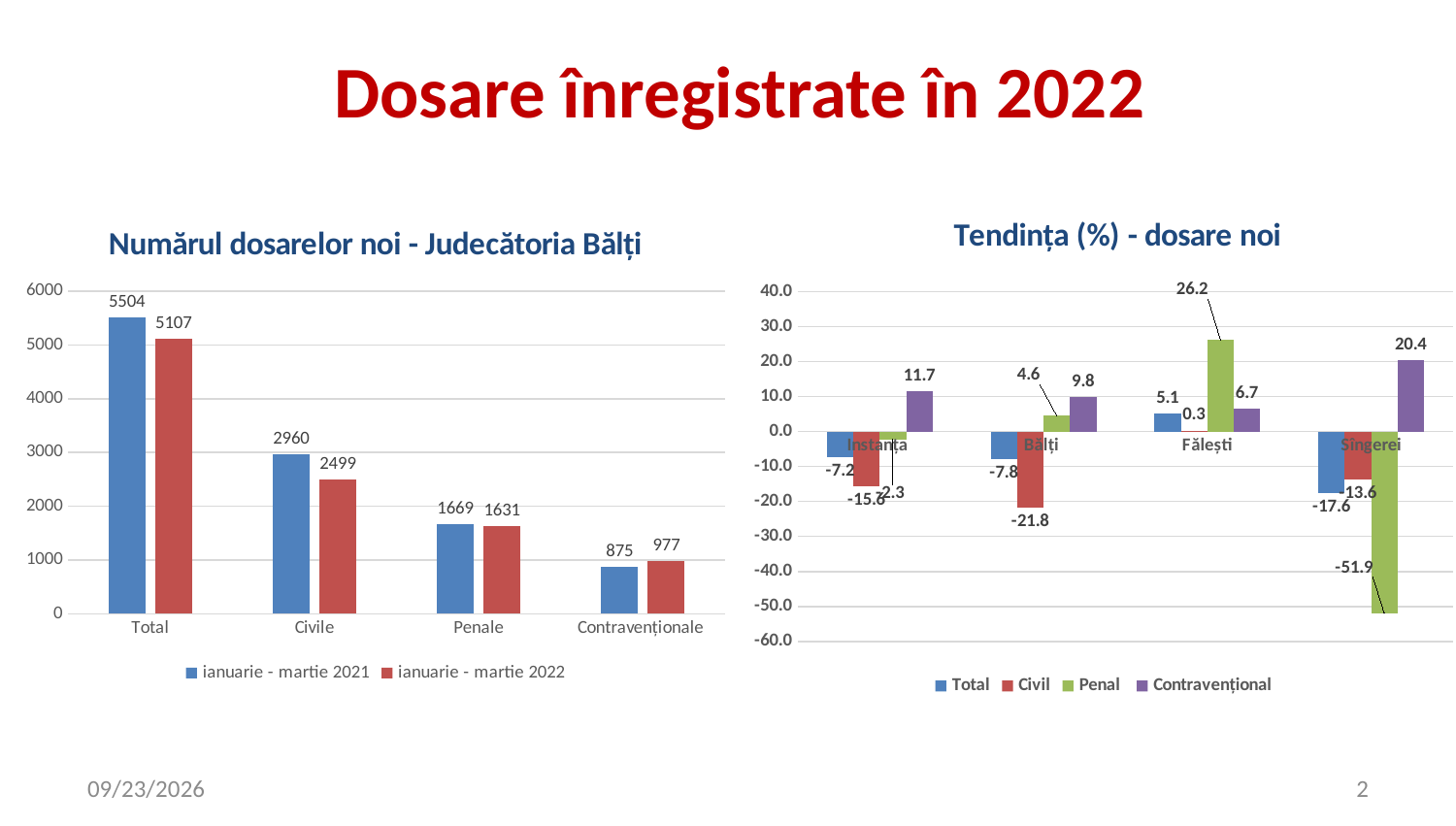
In the chart 'Numărul dosarelor noi - Judecătoria Bălți', what is the difference between the Civile values for ianuarie - martie 2021 and ianuarie - martie 2022? 461 In the chart 'Numărul dosarelor noi - Judecătoria Bălți', what is the value for Contravenționale in ianuarie - martie 2022? 977 In the chart 'Tendința (%) - dosare noi', what is the Penal value for Sîngerei? -51.9 In the chart 'Numărul dosarelor noi - Judecătoria Bălți', which category has the lowest value for ianuarie - martie 2021? Contravenționale In the chart 'Tendința (%) - dosare noi', which series is shown in purple? Contravențional In the chart 'Numărul dosarelor noi - Judecătoria Bălți', which is larger for Penale: ianuarie - martie 2021 or ianuarie - martie 2022? ianuarie - martie 2021 How many series does the legend of the chart 'Numărul dosarelor noi - Judecătoria Bălți' list? 2 How many categories are shown on the x axis of the chart 'Tendința (%) - dosare noi'? 4 In the chart 'Numărul dosarelor noi - Judecătoria Bălți', what is the value for Total in ianuarie - martie 2021? 5504 In the chart 'Tendința (%) - dosare noi', what is the Contravențional value for Fălești? 6.7 What kind of chart is 'Tendința (%) - dosare noi'? Bar chart In the chart 'Tendința (%) - dosare noi', which category has the highest Penal value? Fălești